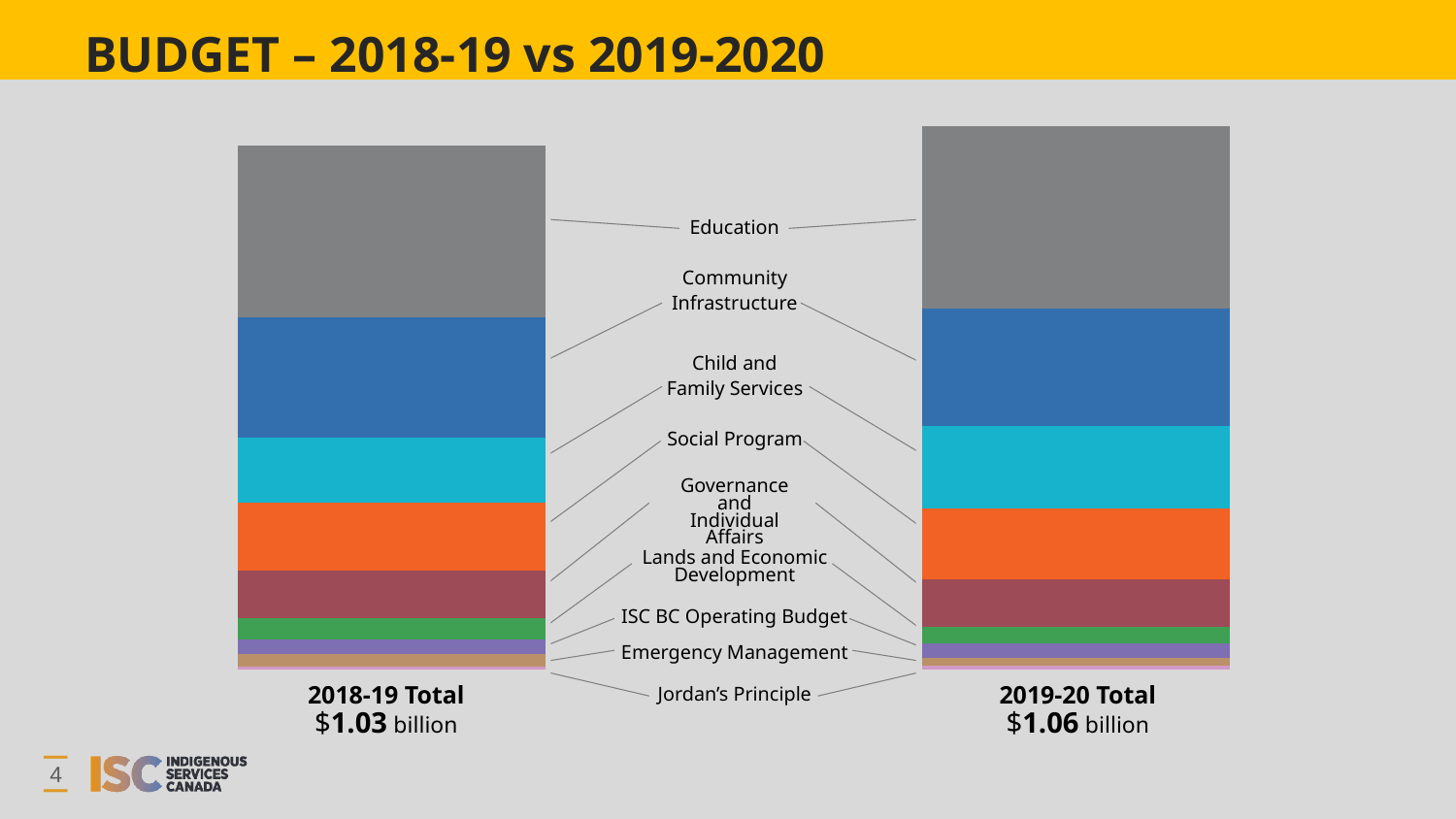
What is the total budget shown for 2018-19? $1.03 billion What colour is the Education segment in the bars? Grey Which category is the smallest segment of the 2018-19 bar? Jordan's Principle What is the total budget shown for 2019-20? $1.06 billion What kind of chart is shown on the slide? Stacked bar chart Which year has the larger total budget, 2018-19 or 2019-20? 2019-20 What is the title of the slide? BUDGET – 2018-19 vs 2019-2020 How many budget categories are labelled in the chart? 9 Does the total budget rise or fall from 2018-19 to 2019-20? Rise Which category makes up the largest segment of the 2019-20 bar? Education Which category makes up the largest segment of the 2018-19 bar? Education By how much does the 2019-20 total exceed the 2018-19 total? $0.03 billion